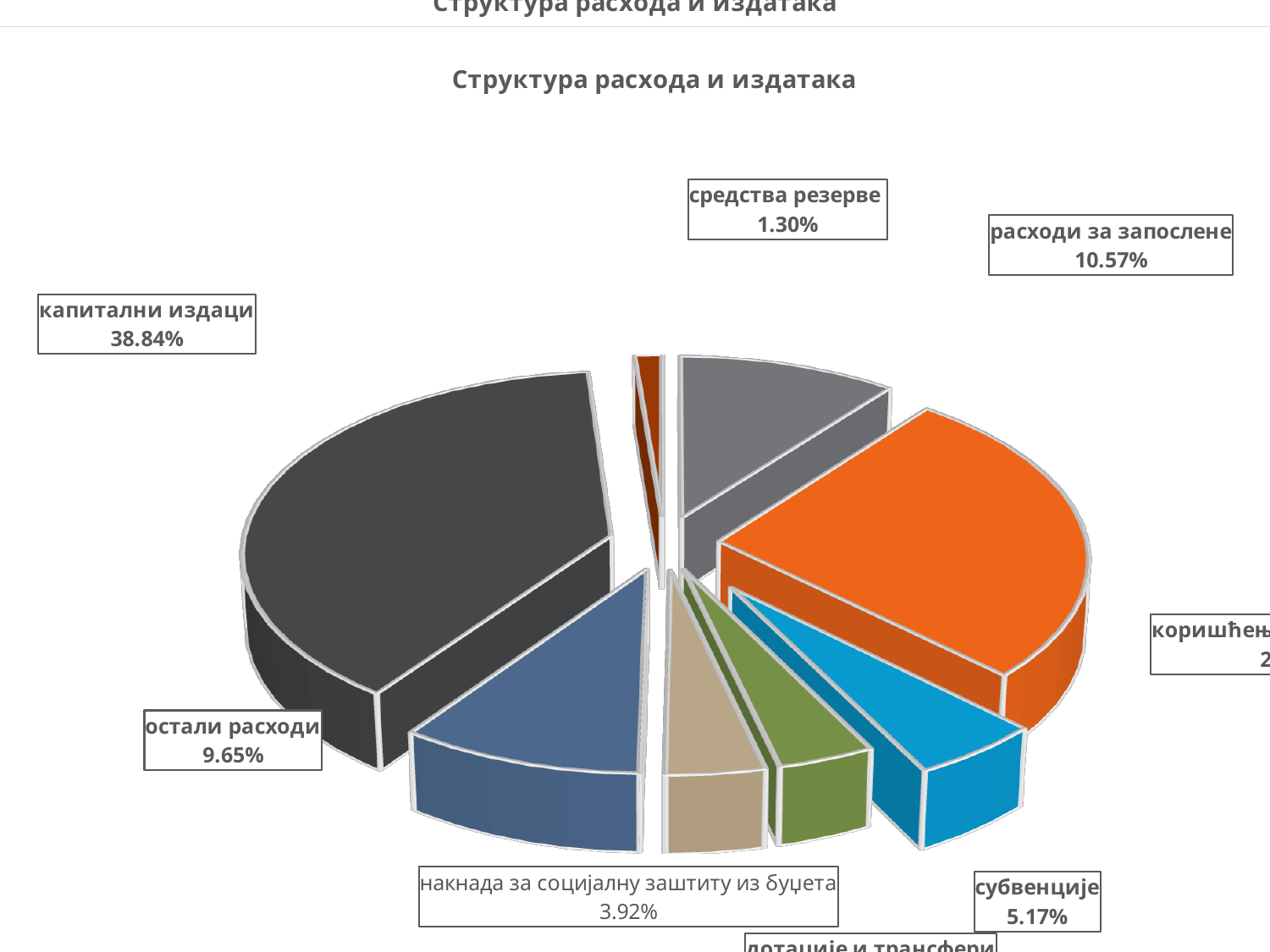
What is the value shown for расходи за запослене? 10.57% Which is larger, субвенције or накнада за социјалну заштиту из буџета? субвенције What kind of chart is shown on the slide? Pie chart What is the value shown for накнада за социјалну заштиту из буџета? 3.92% Which category has the smallest slice of the pie? средства резерве What is the value shown for субвенције? 5.17% What is the value shown for остали расходи? 9.65% Which category has the largest slice of the pie? капитални издаци What share of the pie is капитални издаци? 38.84% What is the value shown for средства резерве? 1.30% What is the difference in percentage points between расходи за запослене and остали расходи? 0.92 What is the title of the chart? Структура расхода и издатака